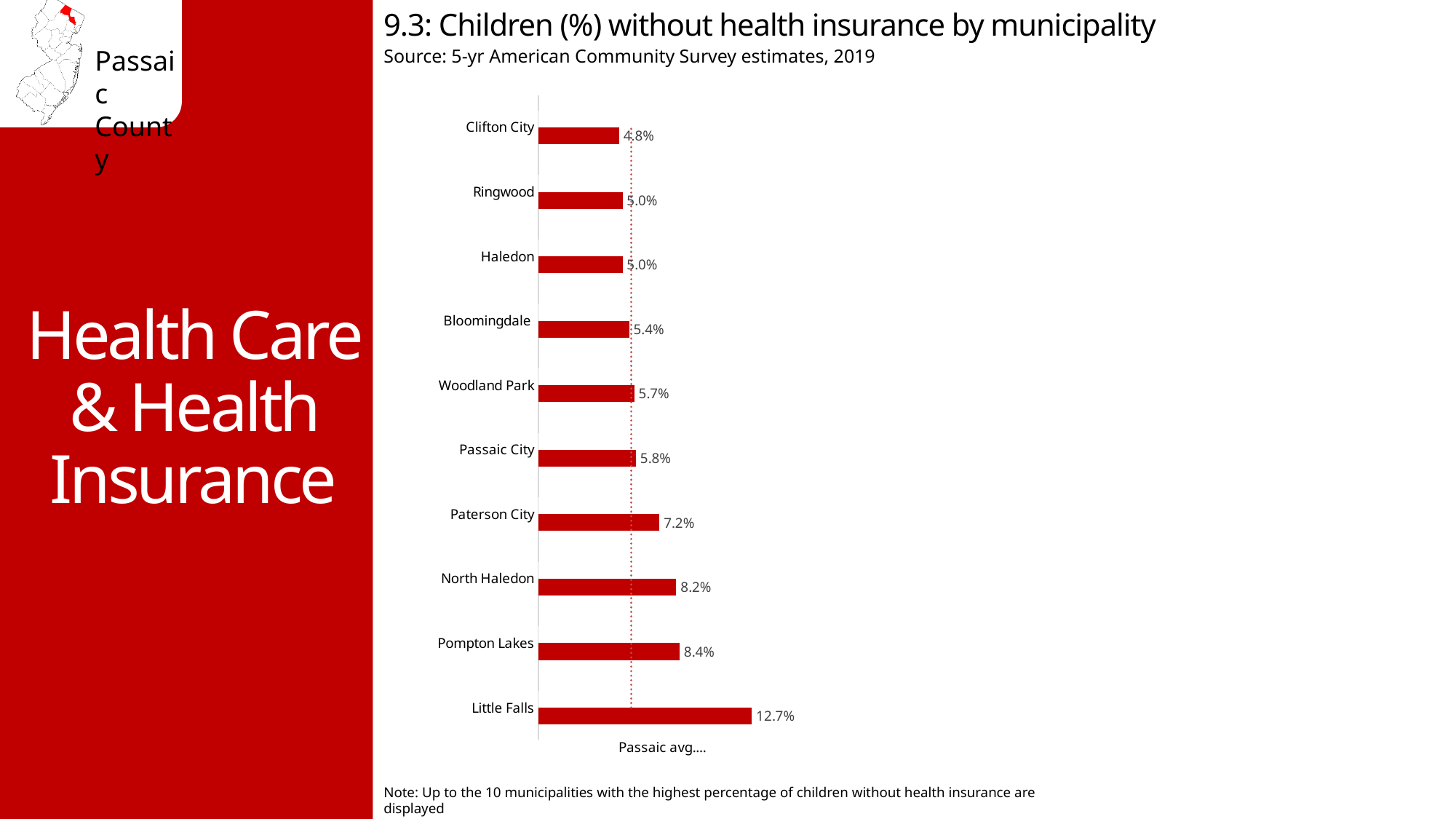
What is the value shown for Bloomingdale? 5.4% How many municipalities are shown in the chart? 10 Which has a higher value, Paterson City or Woodland Park? Paterson City Which municipality has the highest percentage of children without health insurance? Little Falls Which municipality has the lowest percentage of children without health insurance? Clifton City What is the value shown for Paterson City? 7.2% What is the difference between the values for Little Falls and Pompton Lakes? 4.3% What is the value shown for Clifton City? 4.8% What percentage of children in Little Falls are without health insurance? 12.7% What kind of chart is shown on the slide? Bar chart What is the difference between the values for North Haledon and Passaic City? 2.4% What is the source of the data shown in the chart? 5-yr American Community Survey estimates, 2019